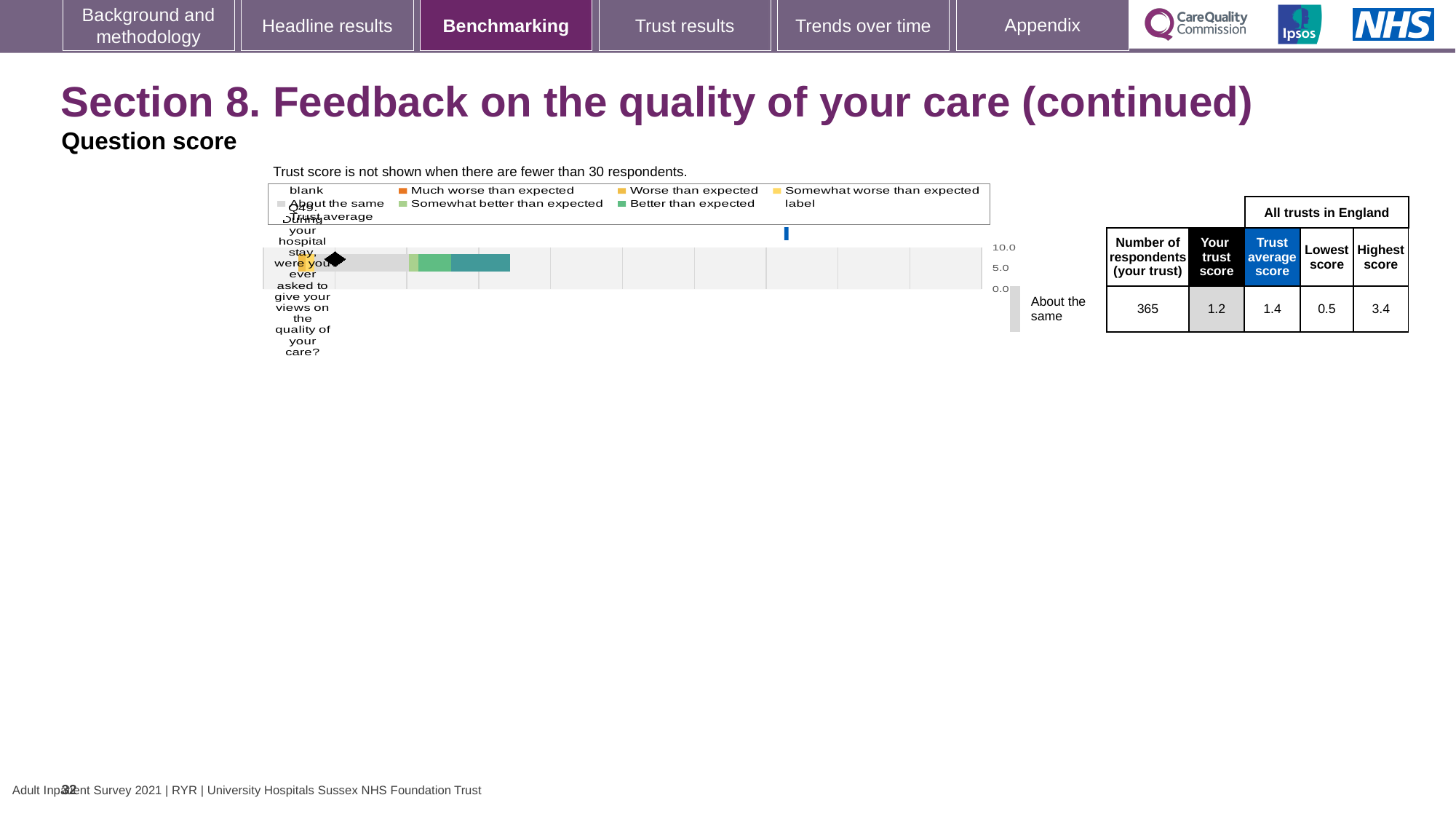
What colour does the legend use for 'Much worse than expected'? orange What kind of chart is shown on the slide? bar chart How many questions (categories) are plotted in the chart? 1 What is the difference between the highest score and the lowest score for Q49 in the table? 2.9 Which question is plotted in the chart? Q49. During your hospital stay, were you ever asked to give your views on the quality of your care? According to the table beside the chart, what is the trust average score for Q49? 1.4 What benchmark category label is shown next to the chart for Q49? About the same Which is larger for Q49: the trust's score or the trust average score? Trust average score According to the table beside the chart, how many respondents did the trust have for Q49? 365 According to the table beside the chart, what is the trust's score for Q49? 1.2 According to the table beside the chart, what is the highest score among all trusts in England for Q49? 3.4 How many entries does the chart legend list? 9